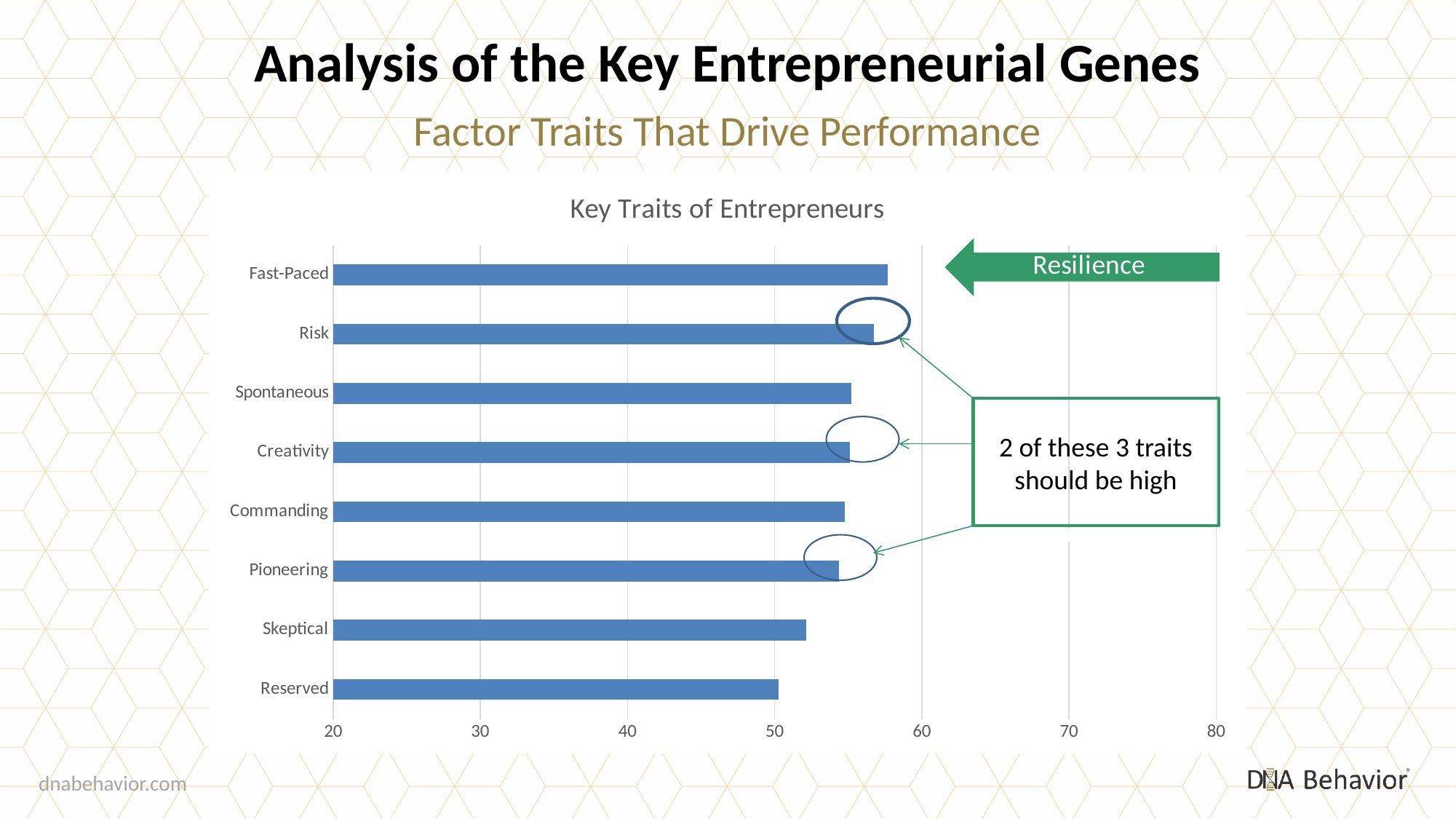
Is the value for Reserved greater or less than 60? less Is the value for Fast-Paced greater or less than 60? less Which is larger, the value for Reserved or the value for Spontaneous? Spontaneous What is the title of the chart? Key Traits of Entrepreneurs Is the value for Skeptical greater or less than 50? greater What type of chart is shown on the slide? Bar chart Which is larger, the value for Risk or the value for Skeptical? Risk Do the bar values increase or decrease going from the top category to the bottom category? Decrease Which trait has the lowest value in the chart? Reserved Which three traits are circled on the chart as the ones where 2 of 3 should be high? Risk, Creativity, Pioneering How many traits (categories) are plotted in the chart? 8 Which trait has the highest value in the chart? Fast-Paced